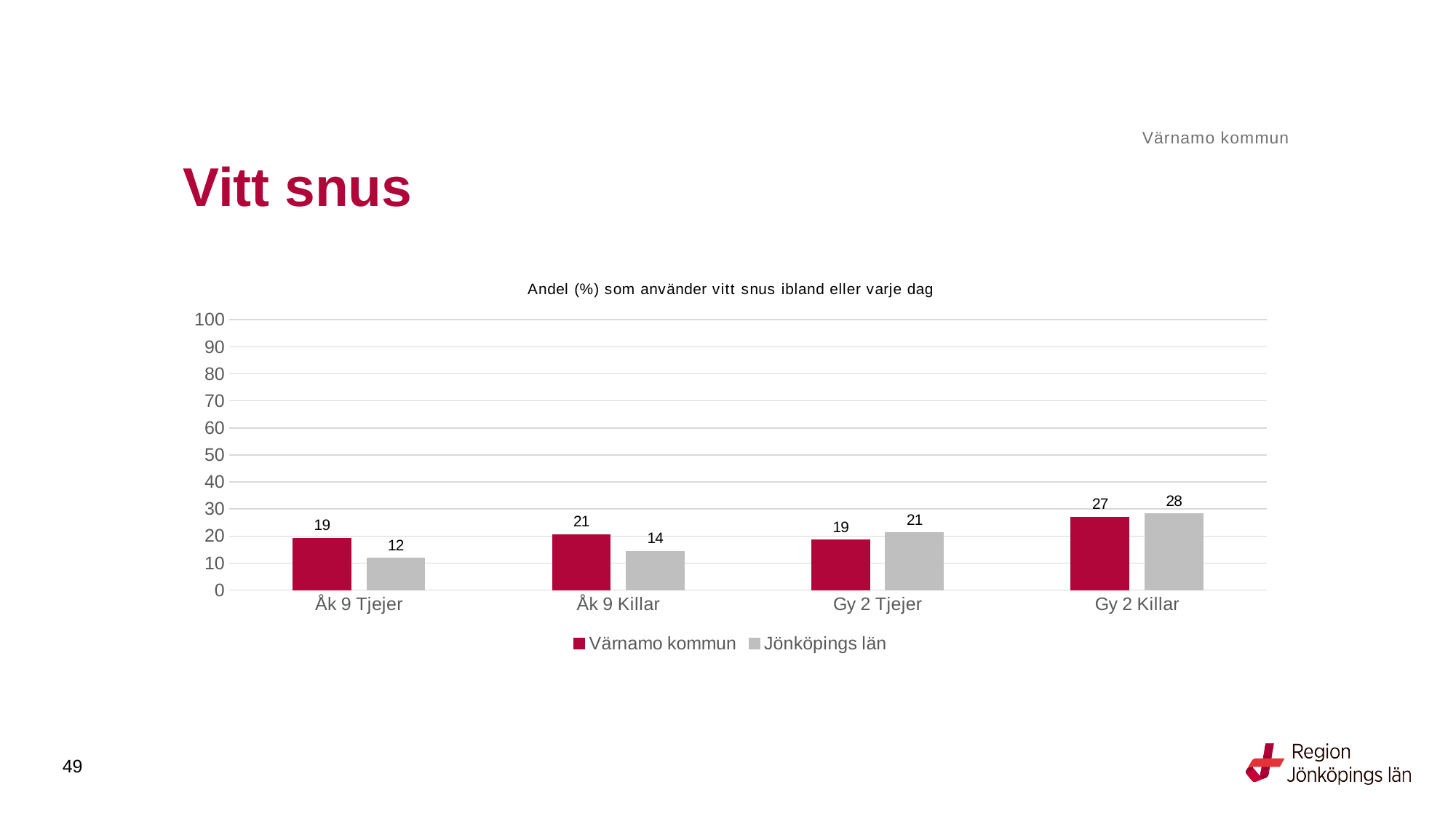
In the Gy 2 Tjejer category, which series has the larger value, Värnamo kommun or Jönköpings län? Jönköpings län How many categories are shown on the x axis? 4 How many series does the legend list? 2 What is the title of the chart? Andel (%) som använder vitt snus ibland eller varje dag What is the value for Jönköpings län in the Åk 9 Killar category? 14 What kind of chart is shown on the slide? Bar chart What is the difference between Värnamo kommun and Jönköpings län in the Åk 9 Killar category? 7 Which category has the lowest value for Jönköpings län? Åk 9 Tjejer What is the value for Jönköpings län in the Gy 2 Killar category? 28 What is the difference between Värnamo kommun and Jönköpings län in the Åk 9 Tjejer category? 7 Which category has the highest value for Värnamo kommun? Gy 2 Killar What is the value for Värnamo kommun in the Åk 9 Tjejer category? 19